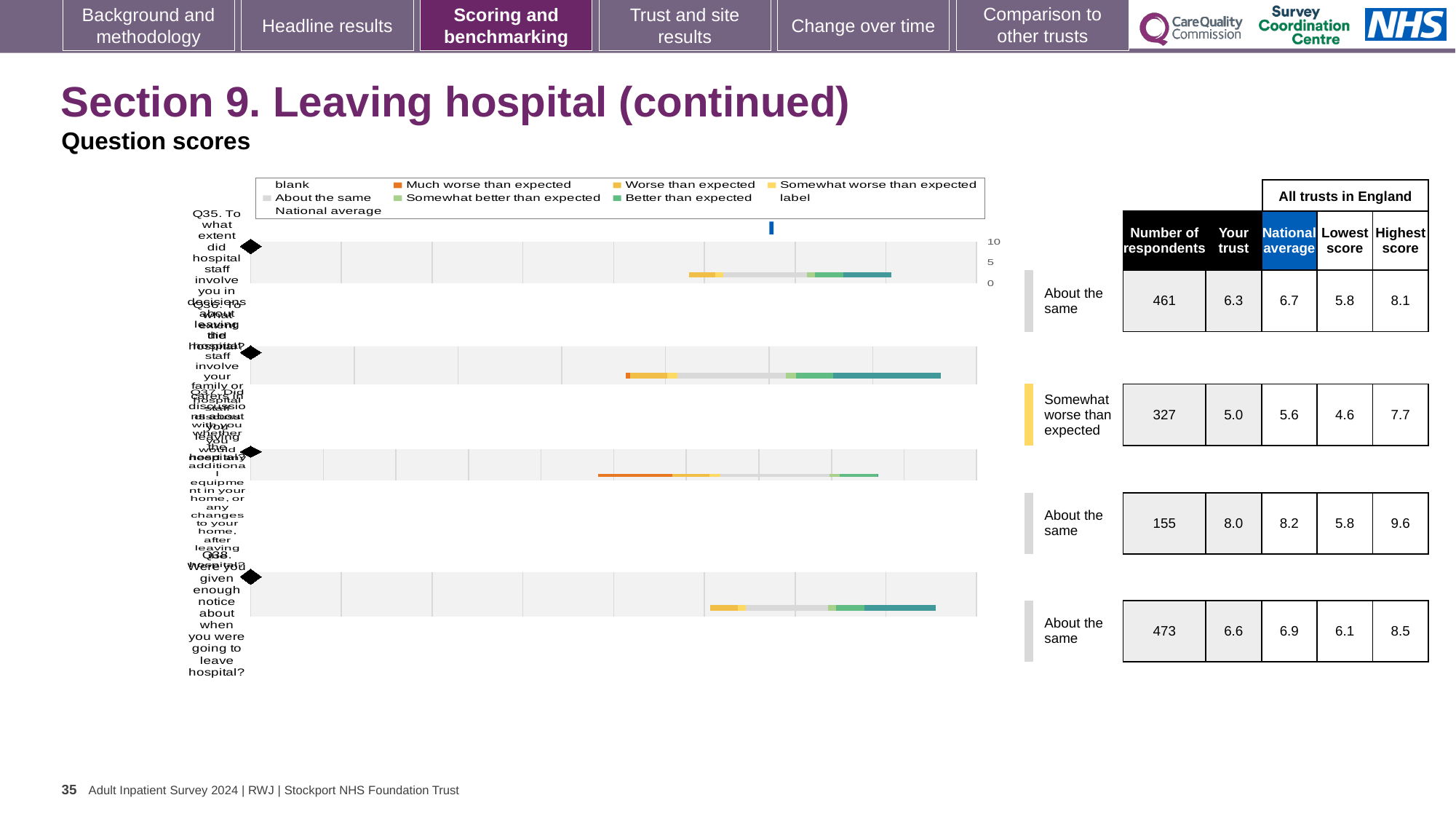
Which row has the highest 'Your trust' score? Q37 (third row) What is the number of respondents for Q38 (Were you given enough notice about when you were going to leave hospital?)? 473 Which row has the lowest number of respondents? Q37 (third row) What is the national average for the second row (Q36), the one rated 'Somewhat worse than expected'? 5.6 Is the 'Your trust' score for Q38 higher or lower than the national average for Q38? lower What is the 'Your trust' score for Q35 (To what extent did hospital staff involve you in decisions about leaving the hospital?)? 6.3 What kind of chart is shown on the slide? bar chart What is the difference between the national average and the 'Your trust' score for Q36 (second row)? 0.6 What is the highest score across all trusts in England for the third row (Q37)? 9.6 Which row is rated 'Somewhat worse than expected' rather than 'About the same'? Q36 (second row) How many questions (rows) are plotted in the chart? 4 What is the lowest score across all trusts in England for Q35 (first row)? 5.8